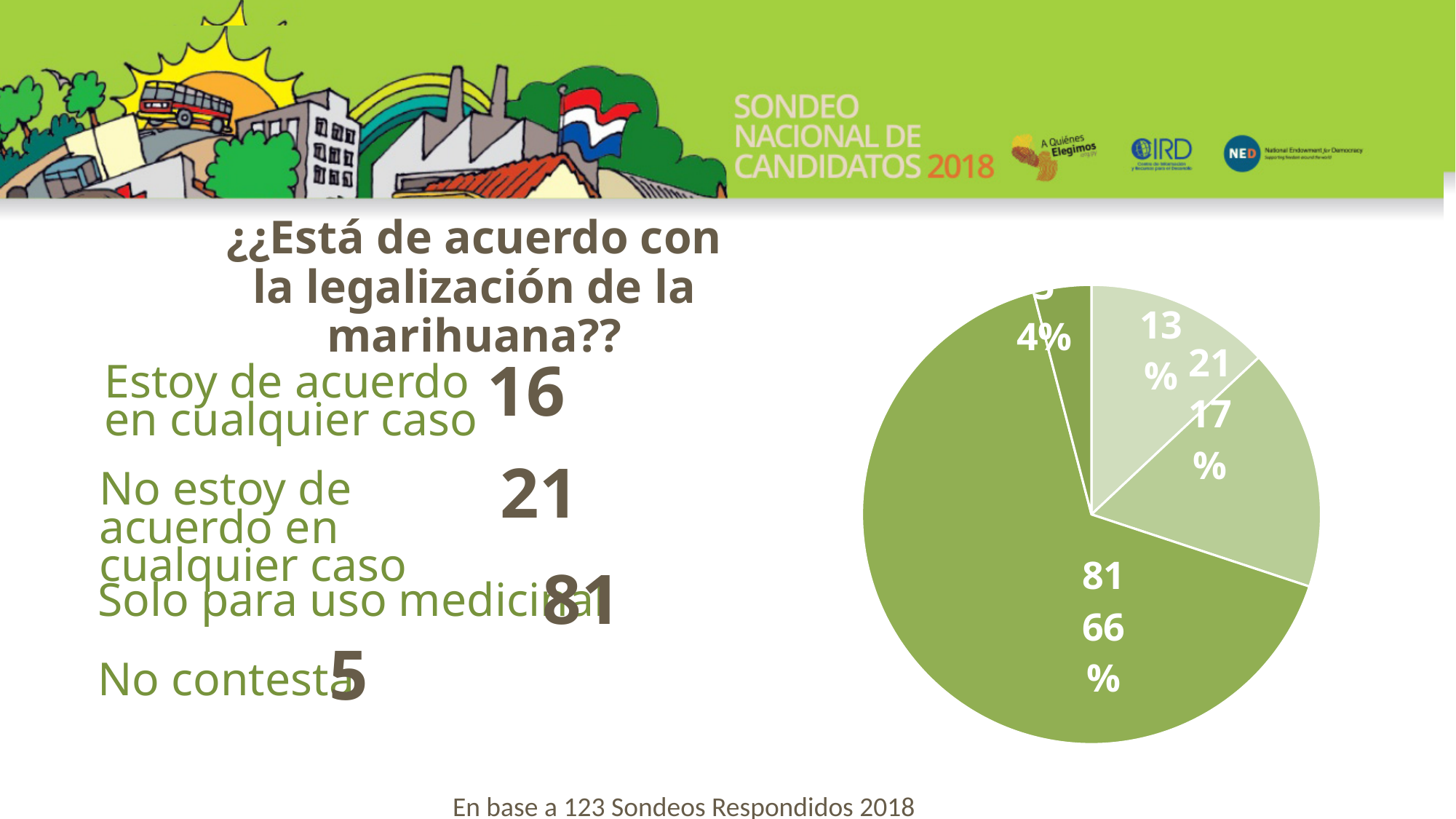
What share of the pie does 'No contestó' represent? 4% What share of the pie does 'No estoy de acuerdo en cualquier caso' represent? 17% What kind of chart is shown on the slide? pie chart What is the difference between the number of respondents for 'Solo para uso medicinal' and 'No estoy de acuerdo en cualquier caso'? 60 Which response has the largest slice of the pie chart? Solo para uso medicinal How many respondents answered 'No estoy de acuerdo en cualquier caso'? 21 What share of the pie does 'Estoy de acuerdo en cualquier caso' represent? 13% Which has more respondents: 'Estoy de acuerdo en cualquier caso' or 'No estoy de acuerdo en cualquier caso'? No estoy de acuerdo en cualquier caso How many slices does the pie chart have? 4 How many respondents answered 'Solo para uso medicinal'? 81 Which response has the smallest slice of the pie chart? No contestó